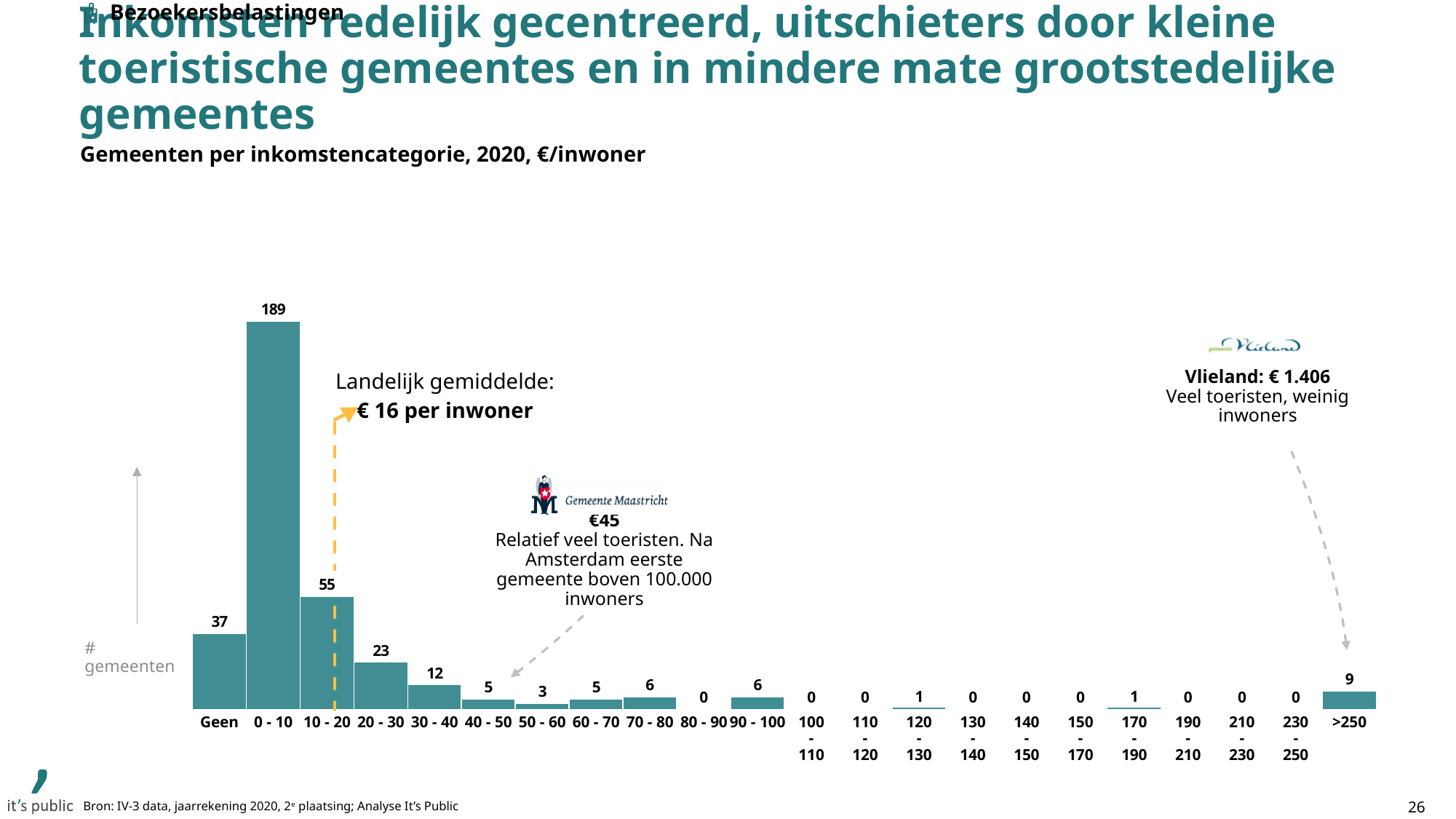
What is the difference between the 0 - 10 and 10 - 20 categories? 134 How many municipalities are in the >250 category? 9 What type of chart is shown on the slide? Bar chart What is the difference between the 'Geen' category and the 20 - 30 category? 14 What is the value shown for the 10 - 20 category? 55 How many income categories are shown on the x axis? 22 How many municipalities fall in the 0 - 10 income category? 189 What national average (Landelijk gemiddelde) is annotated on the chart? € 16 per inwoner What is the value for the 'Geen' category? 37 Which is larger, the value for 30 - 40 or the value for >250? 30 - 40 Which income category has the highest number of municipalities? 0 - 10 Which has more municipalities, the 70 - 80 category or the 50 - 60 category? 70 - 80